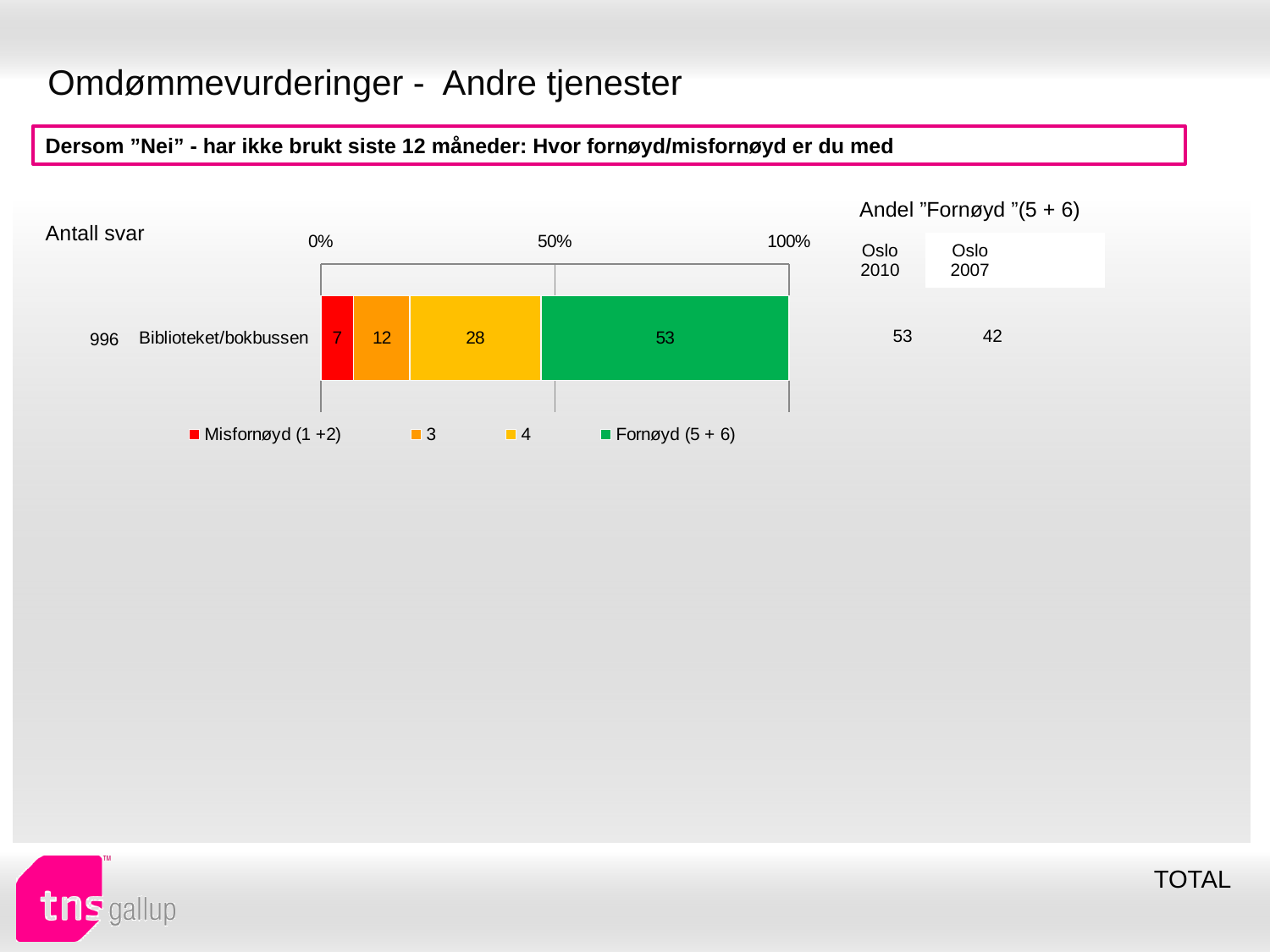
Which is larger for Biblioteket/bokbussen, the "4" segment or the "3" segment? 4 What is the difference between the "Fornøyd (5 + 6)" and "Misfornøyd (1 +2)" segments for Biblioteket/bokbussen? 46 What is the number of responses (Antall svar) shown for Biblioteket/bokbussen? 996 Which segment of the Biblioteket/bokbussen bar has the smallest value? Misfornøyd (1 +2) Which segment of the Biblioteket/bokbussen bar has the largest value? Fornøyd (5 + 6) What is the value of the "Fornøyd (5 + 6)" segment for Biblioteket/bokbussen? 53 What is the value of the "3" segment for Biblioteket/bokbussen? 12 What kind of chart is shown on the slide? Stacked bar chart What is the value of the "Misfornøyd (1 +2)" segment for Biblioteket/bokbussen? 7 How many categories are plotted in the chart? 1 What is the value of the "4" segment for Biblioteket/bokbussen? 28 How many series does the legend list? 4